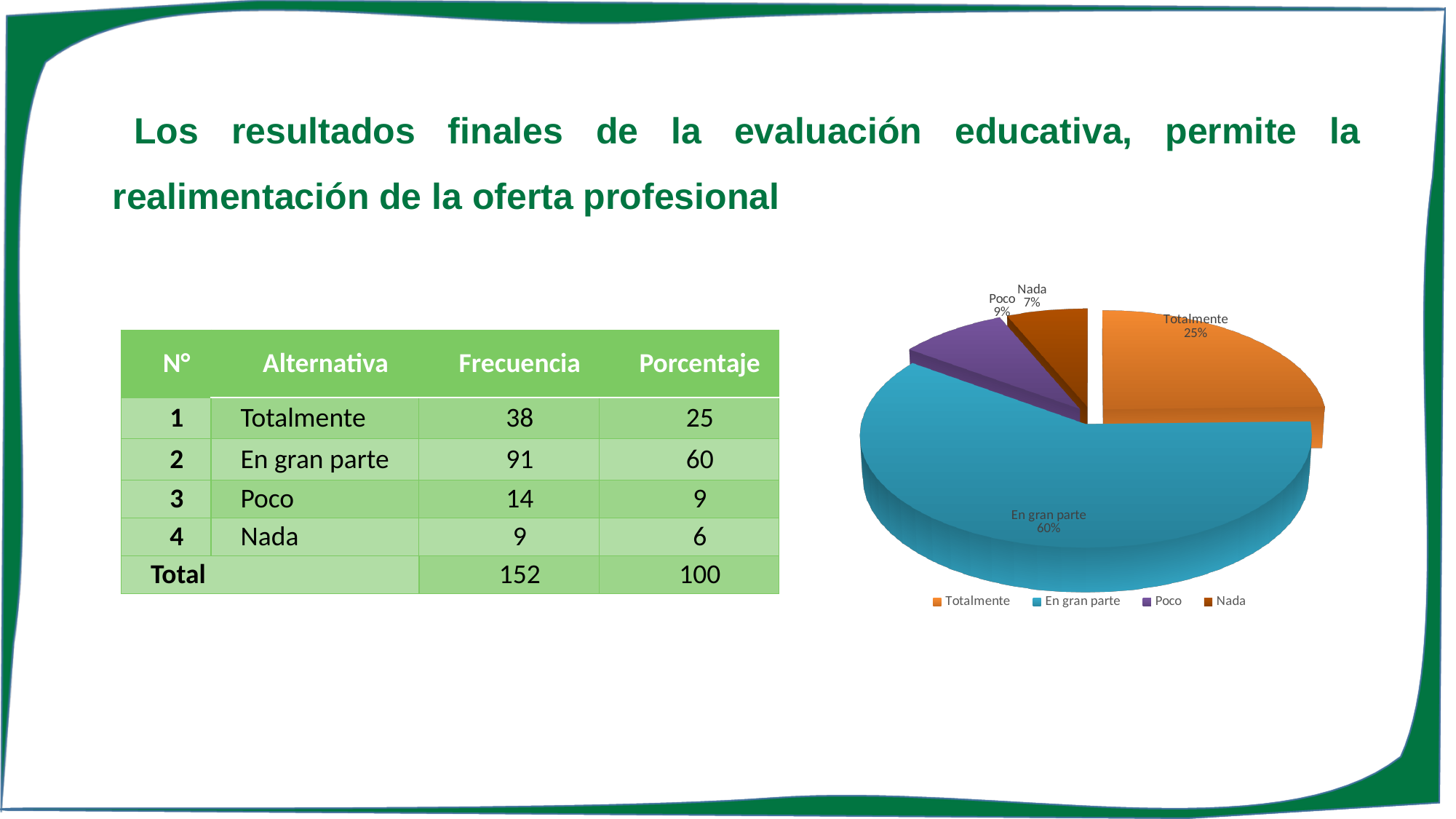
In the pie chart, what percentage is shown for "Totalmente"? 25% What colour is the "En gran parte" slice in the pie chart? blue What kind of chart is shown on the slide? pie chart In the pie chart, what percentage is shown for "Nada"? 7% How many entries does the pie chart's legend list? 4 In the pie chart, what is the difference in percentage points between "En gran parte" and "Totalmente"? 35 Which slice of the pie chart is the largest? En gran parte In the pie chart, what percentage is shown for "En gran parte"? 60% How many slices does the pie chart have? 4 In the pie chart, which is larger: the slice for "Totalmente" or the slice for "Poco"? Totalmente In the pie chart, what percentage is shown for "Poco"? 9% Which slice of the pie chart is the smallest? Nada